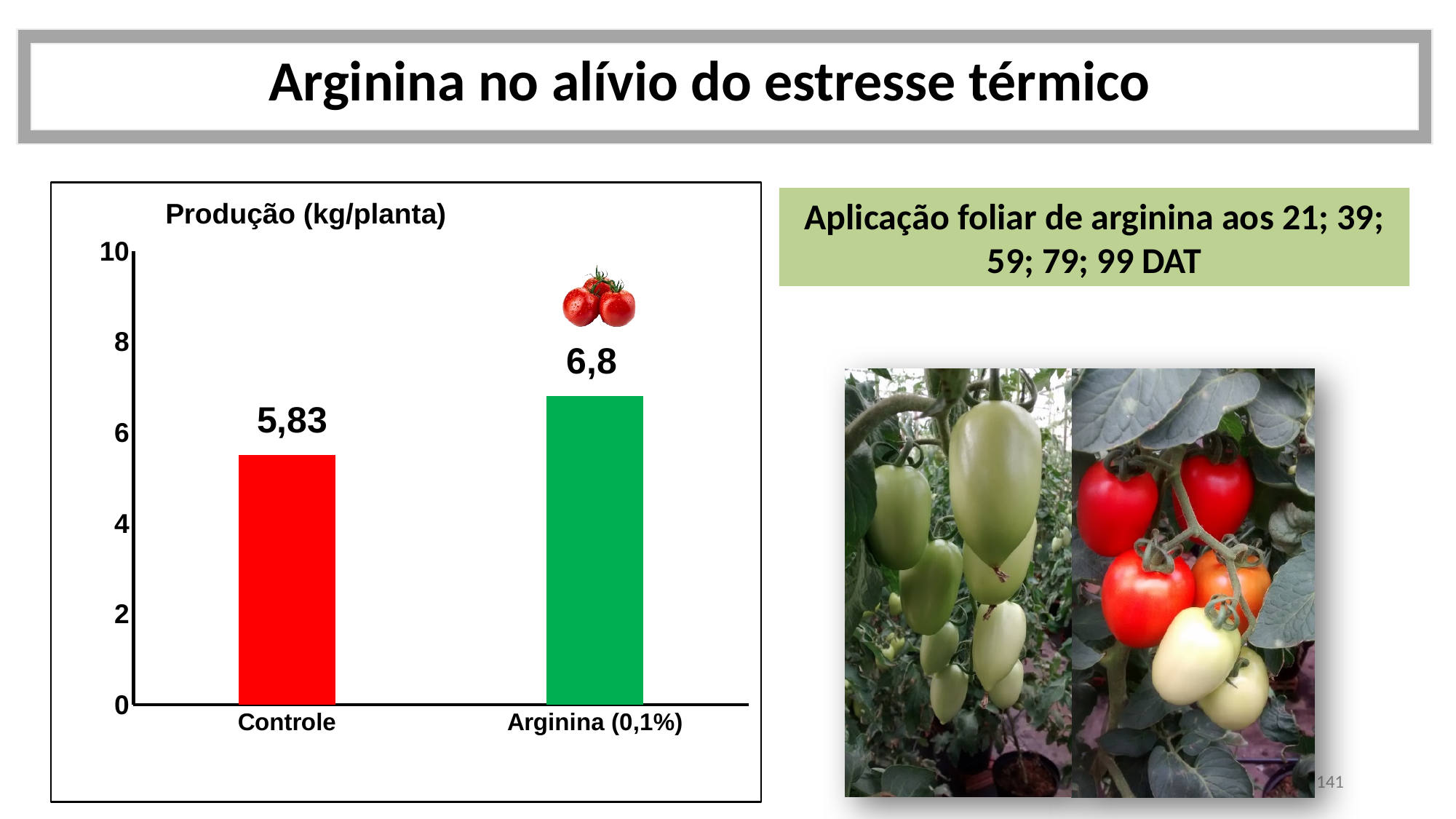
What kind of chart is shown on the slide? bar chart What colour is the bar for Arginina (0,1%)? green What is the difference between the values for Arginina (0,1%) and Controle? 0,97 Which is larger, the value for Controle or the value for Arginina (0,1%)? Arginina (0,1%) Which category has the highest value? Arginina (0,1%) What is the title of the chart? Produção (kg/planta) Is the value for Arginina (0,1%) greater or less than 6? greater What is the value for Controle? 5,83 How many categories are shown on the chart? 2 Which category has the lowest value? Controle What is the value for Arginina (0,1%)? 6,8 Is the value for Controle greater or less than 6? less